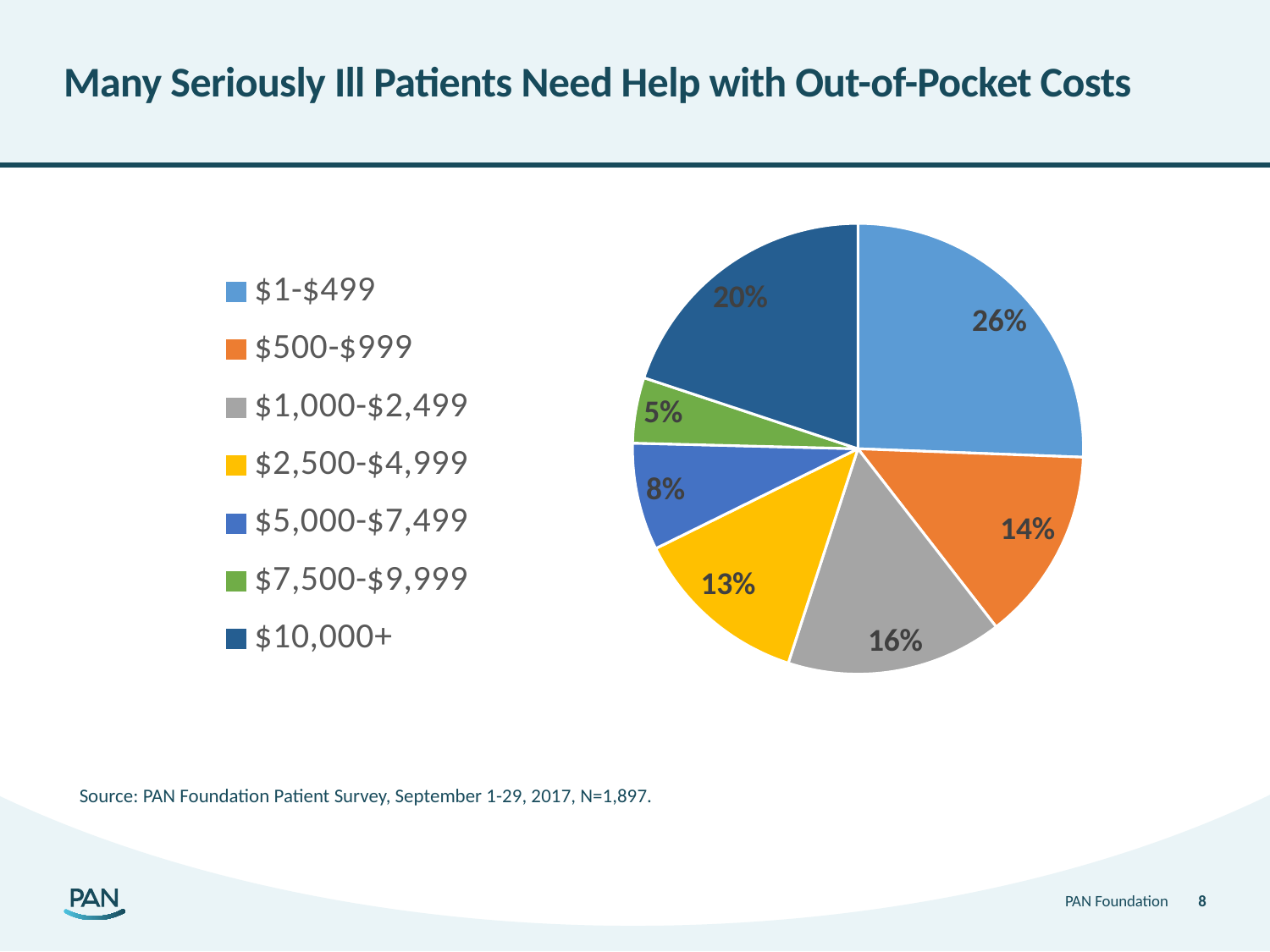
What colour is the $500-$999 slice in the pie chart? orange What share of the pie does the $1-$499 slice represent? 26% What is the difference between the $1,000-$2,499 slice and the $500-$999 slice? 2% What is the value shown for the $2,500-$4,999 slice? 13% What kind of chart is shown on the slide? pie chart Which category has the largest slice of the pie? $1-$499 What is the value shown for the $10,000+ slice? 20% Which category has the smallest slice of the pie? $7,500-$9,999 What is the value shown for the $7,500-$9,999 slice? 5% How many categories does the pie chart have? 7 What is the difference between the $10,000+ slice and the $5,000-$7,499 slice? 12% Which is larger, the $5,000-$7,499 slice or the $2,500-$4,999 slice? $2,500-$4,999